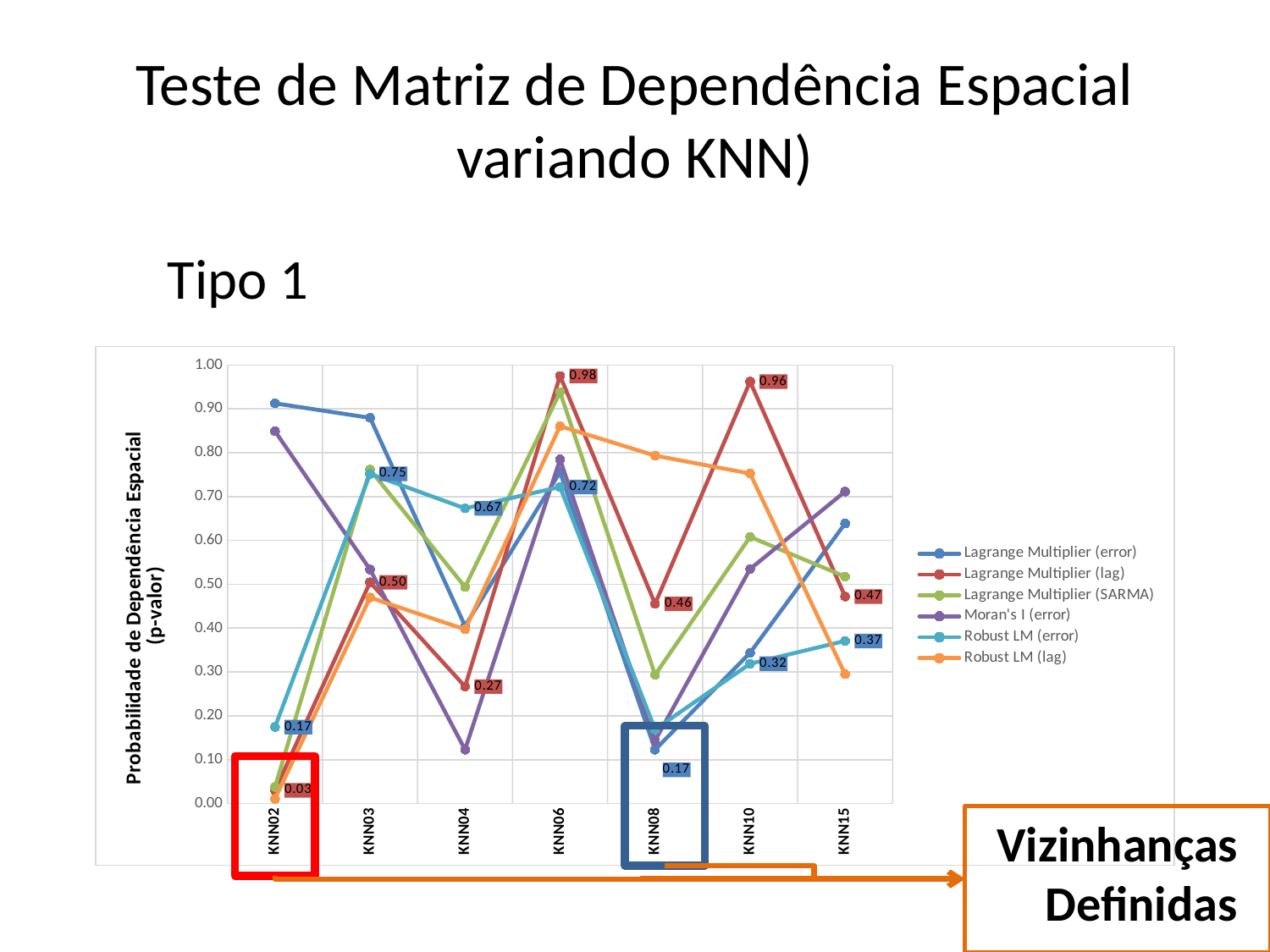
At which KNN category does Lagrange Multiplier (lag) reach its highest value? KNN06 What type of chart is shown on the slide? line chart At KNN06, which is larger: Lagrange Multiplier (lag) or Robust LM (error)? Lagrange Multiplier (lag) What is the value of Lagrange Multiplier (lag) at KNN06? 0.98 What is the difference between the Lagrange Multiplier (lag) values at KNN06 and KNN10? 0.02 Is the value for Lagrange Multiplier (error) at KNN02 greater or less than 0.80? greater How many KNN categories are shown on the x axis? 7 What is the value of Lagrange Multiplier (lag) at KNN02? 0.03 What is the title of the y axis? Probabilidade de Dependência Espacial (p-valor) How many series does the legend list? 6 At which KNN category does Lagrange Multiplier (lag) have its lowest value? KNN02 What is the value of Robust LM (error) at KNN03? 0.75